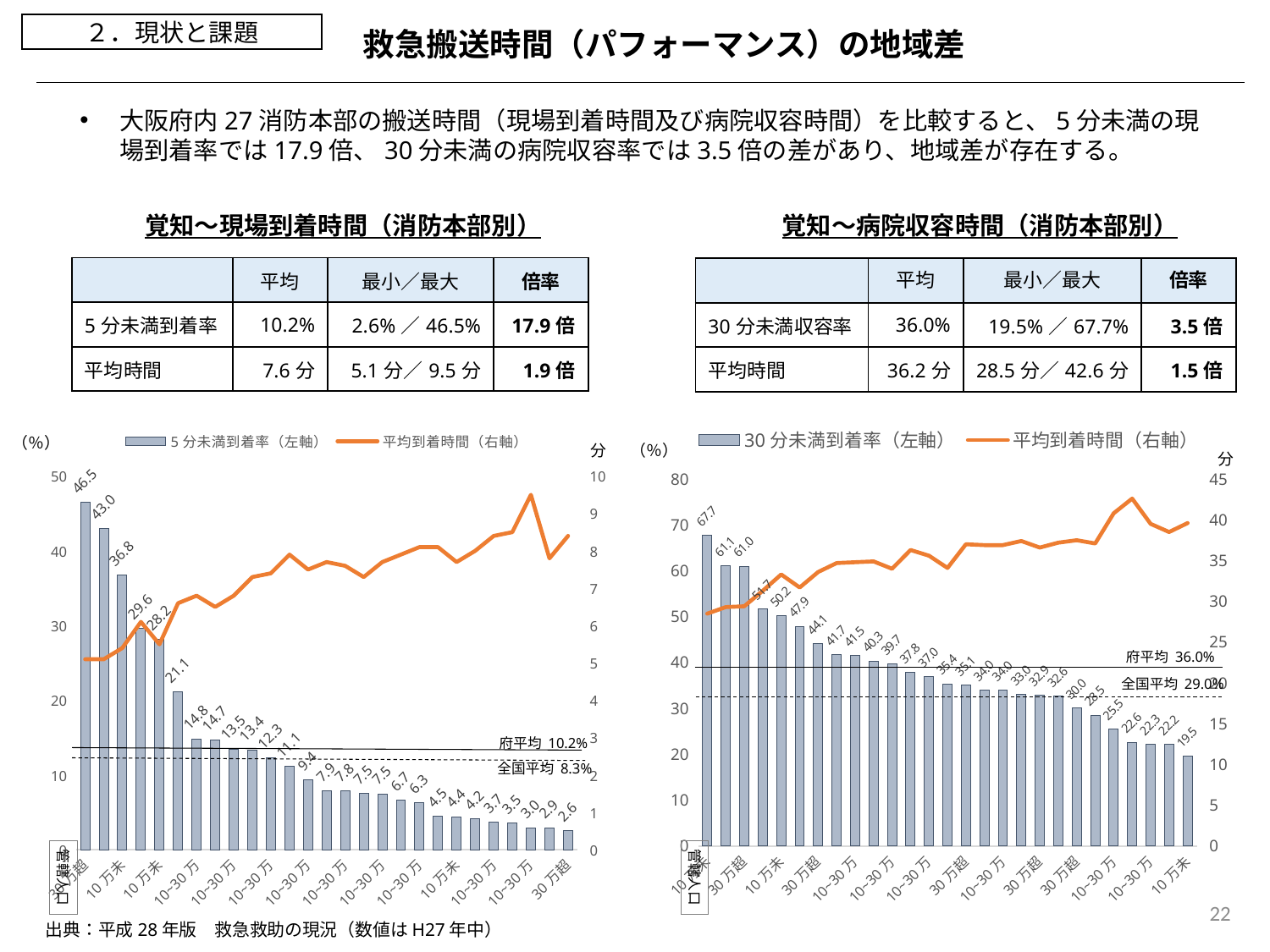
In the left chart (覚知～現場到着時間), how many bars are plotted? 27 In the left chart (覚知～現場到着時間), what is the difference between the highest bar value (46.5) and the lowest bar value (2.6)? 43.9 In the right chart (覚知～病院収容時間), what value is shown for the 全国平均 reference line? 29.0% In the right chart (覚知～病院収容時間), what is the lowest value among the bars for 30分未満到着率? 19.5 In the right chart (覚知～病院収容時間), does the orange line for 平均到着時間 generally rise or fall from left to right? Rise What kind of chart is the left chart (覚知～現場到着時間)? Combined bar and line chart In the right chart (覚知～病院収容時間), what is the highest value among the bars for 30分未満到着率? 67.7 In the left chart (覚知～現場到着時間), what is the lowest value among the bars for 5分未満到着率? 2.6 In the right chart (覚知～病院収容時間), how many series does the legend list? 2 In the left chart (覚知～現場到着時間), do the bar values rise or fall from left to right? Fall In the right chart (覚知～病院収容時間), what is the difference between the highest bar value (67.7) and the lowest bar value (19.5)? 48.2 In the left chart (覚知～現場到着時間), what is the highest value among the bars for 5分未満到着率? 46.5